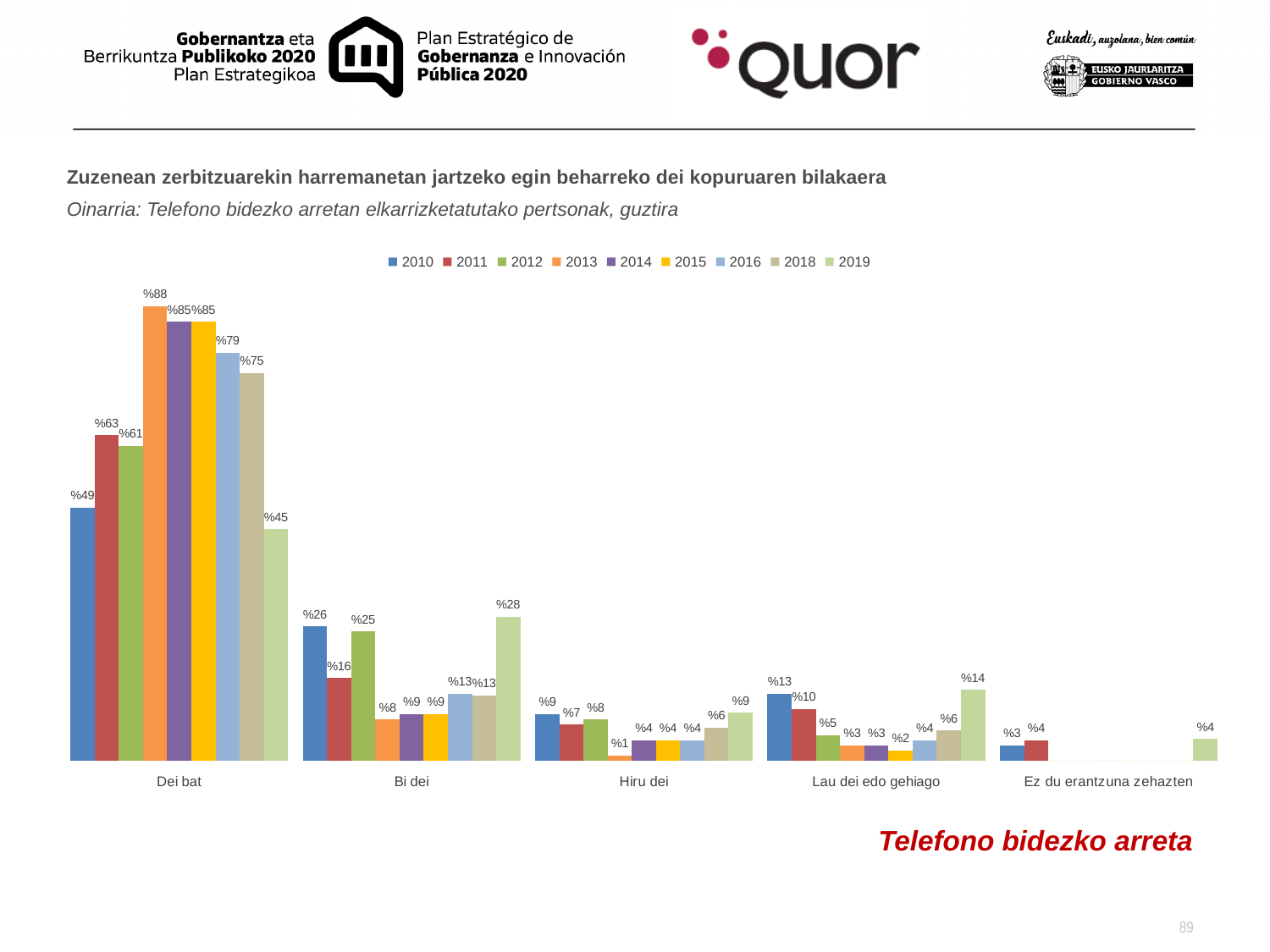
How many series does the legend list? 9 What kind of chart is shown on the slide? Bar chart In the "Bi dei" category, which is larger: the value for 2010 or the value for 2011? 2010 Which year has the lowest value in the "Dei bat" category? 2019 What is the value for 2019 in the "Bi dei" category? %28 What is the value for 2013 in the "Dei bat" category? %88 What is the value for 2010 in the "Lau dei edo gehiago" category? %13 How many categories are shown on the x axis? 5 What is the value for 2013 in the "Hiru dei" category? %1 Which year has the highest value in the "Dei bat" category? 2013 What is the difference between the 2013 and 2019 values in the "Dei bat" category? 43 percentage points Which year has the highest value in the "Lau dei edo gehiago" category? 2019